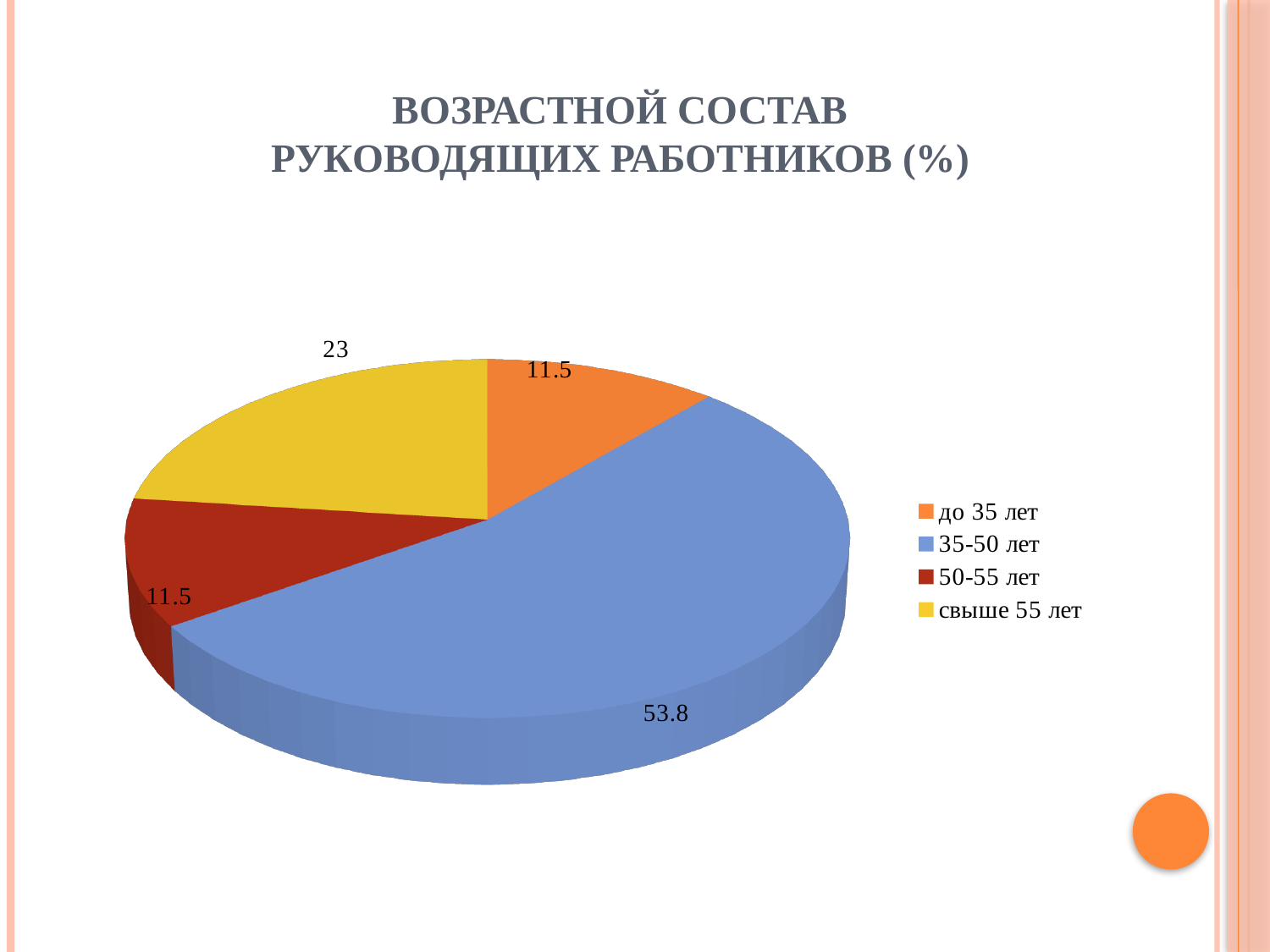
How many categories does the pie chart have? 4 What is the difference between the values for "свыше 55 лет" and "до 35 лет"? 11.5 Which is larger, the value for "35-50 лет" or the value for "свыше 55 лет"? 35-50 лет What is the value for the category "50-55 лет"? 11.5 Which colour represents the category "свыше 55 лет" in the legend? yellow What is the title of the chart? ВОЗРАСТНОЙ СОСТАВ РУКОВОДЯЩИХ РАБОТНИКОВ (%) Which age category has the largest slice of the pie? 35-50 лет What is the value for the category "35-50 лет"? 53.8 What kind of chart is shown on the slide? pie chart What is the value for the category "свыше 55 лет"? 23 What is the difference between the values for "35-50 лет" and "свыше 55 лет"? 30.8 What is the value for the category "до 35 лет"? 11.5